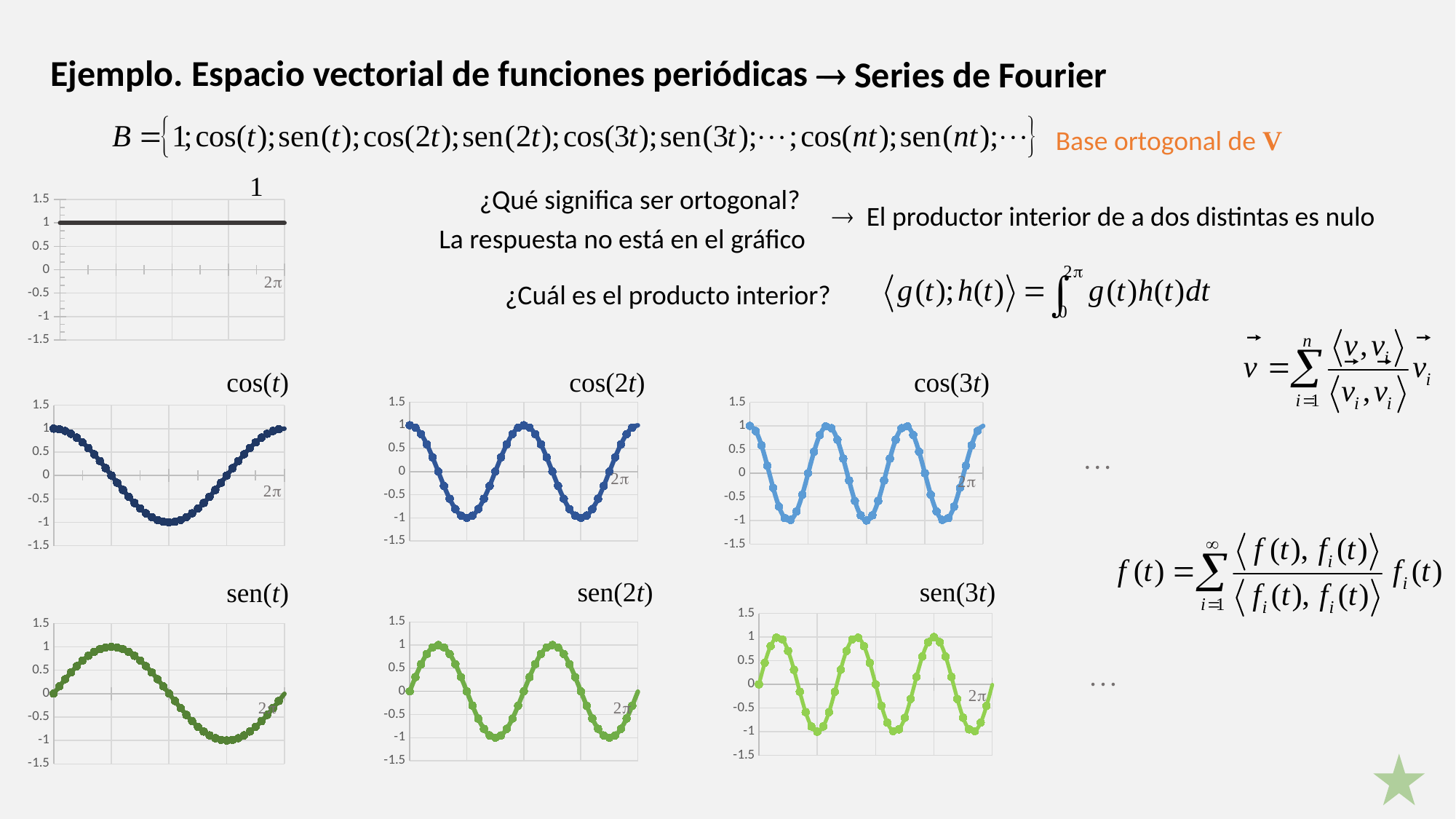
What label marks the right end of the x axis in the chart titled "cos(3t)"? 2π How many charts are shown on the slide? 7 In the chart titled "1", do the values rise, fall or stay constant along the x axis? stay constant In the chart titled "cos(t)", is the value at the middle of the x axis greater or less than 0? less What kind of chart is the chart titled "cos(t)"? line chart In the chart titled "sen(t)", is the value at one quarter of the way along the x axis greater or less than 0.5? greater In the chart titled "cos(t)", what is the value at the left end of the x axis (t = 0)? 1 In the chart titled "1", what constant value does the plotted line take? 1 In the chart titled "cos(2t)", is the value at the middle of the x axis greater or less than 0.5? greater In the chart titled "sen(t)", what is the value at the left end of the x axis (t = 0)? 0 What is the highest value shown on the vertical axis of the chart titled "sen(3t)"? 1.5 In the chart titled "sen(t)", do the values rise or fall over the first quarter of the x axis? rise